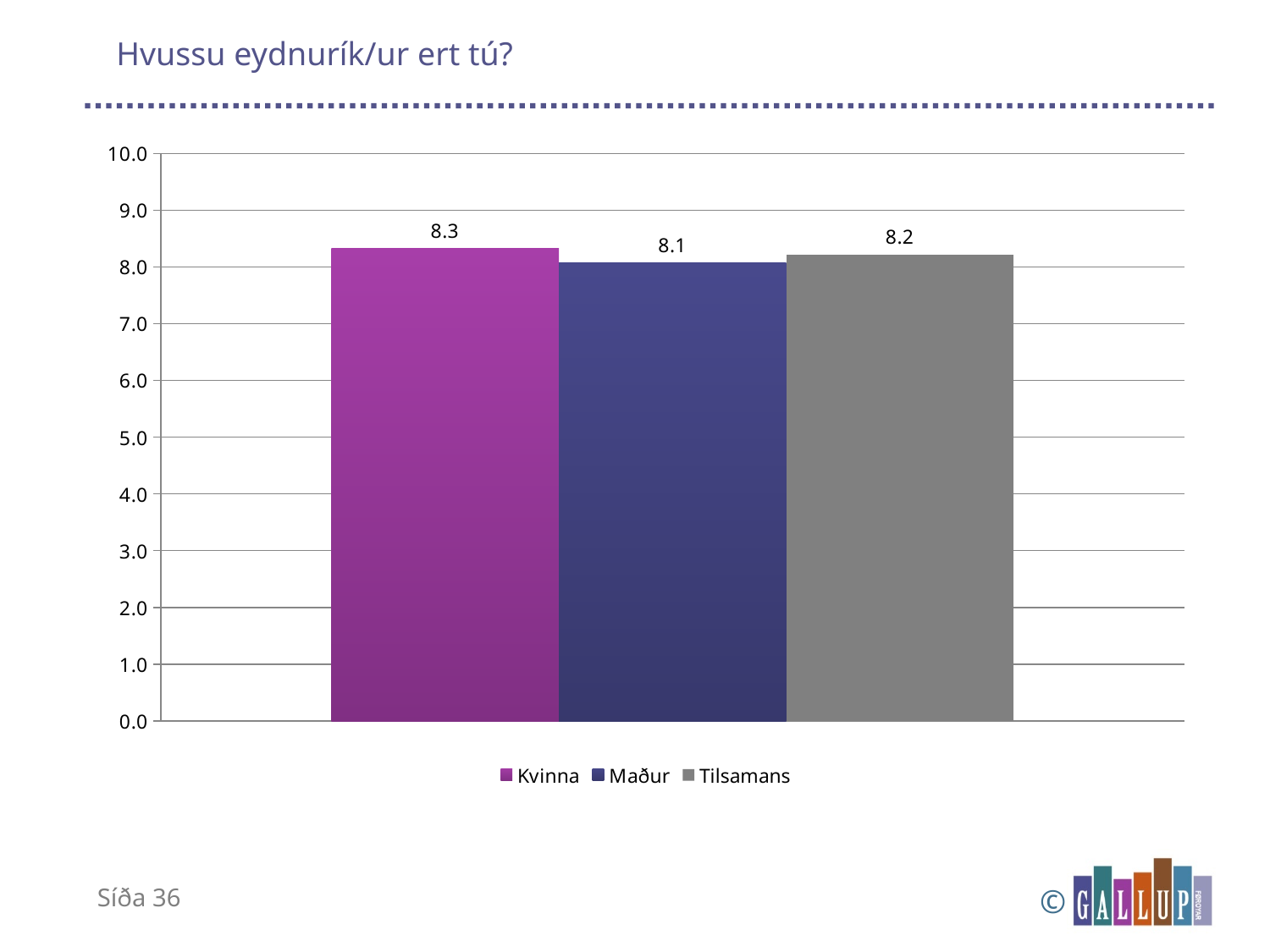
Which series has the highest value? Kvinna What kind of chart is shown on the slide? bar chart How many bars are plotted in the chart? 3 Which is larger, the value for Kvinna or the value for Maður? Kvinna How many series does the legend list? 3 What is the value for Maður? 8.1 What is the difference between the values for Kvinna and Maður? 0.2 What is the value for Tilsamans? 8.2 What is the value for Kvinna? 8.3 What is the title of the slide? Hvussu eydnurík/ur ert tú? Is the value for Tilsamans greater or less than 9.0? less Which series has the lowest value? Maður